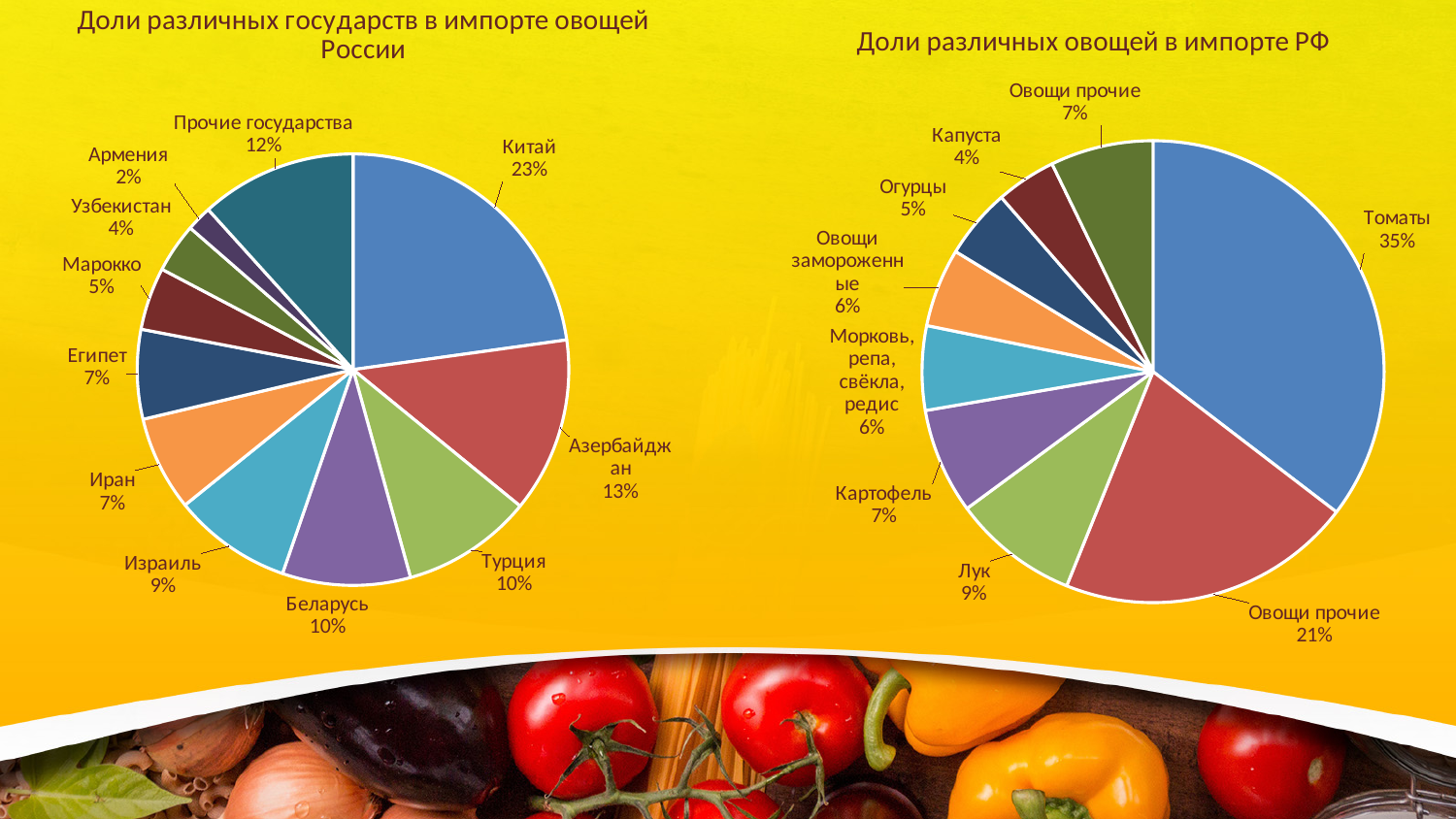
In the chart 'Доли различных овощей в импорте РФ', what share do Томаты have? 35% In the chart 'Доли различных государств в импорте овощей России', what share does Азербайджан have? 13% In the chart 'Доли различных овощей в импорте РФ', what share does Лук have? 9% In the chart 'Доли различных овощей в импорте РФ', what is the difference between the shares of Картофель and Капуста? 3% What type of chart is used on the right side of the slide, 'Доли различных овощей в импорте РФ'? Pie chart In the chart 'Доли различных государств в импорте овощей России', what is the difference between the shares of Китай and Азербайджан? 10% In the chart 'Доли различных государств в импорте овощей России', which country has the smallest share? Армения In the chart 'Доли различных государств в импорте овощей России', what share does Китай have? 23% In the chart 'Доли различных государств в импорте овощей России', which has the larger share, Израиль or Марокко? Израиль In the chart 'Доли различных овощей в импорте РФ', which category has the largest share? Томаты In the chart 'Доли различных государств в импорте овощей России', which category has the largest share? Китай How many slices does the chart 'Доли различных государств в импорте овощей России' have? 11